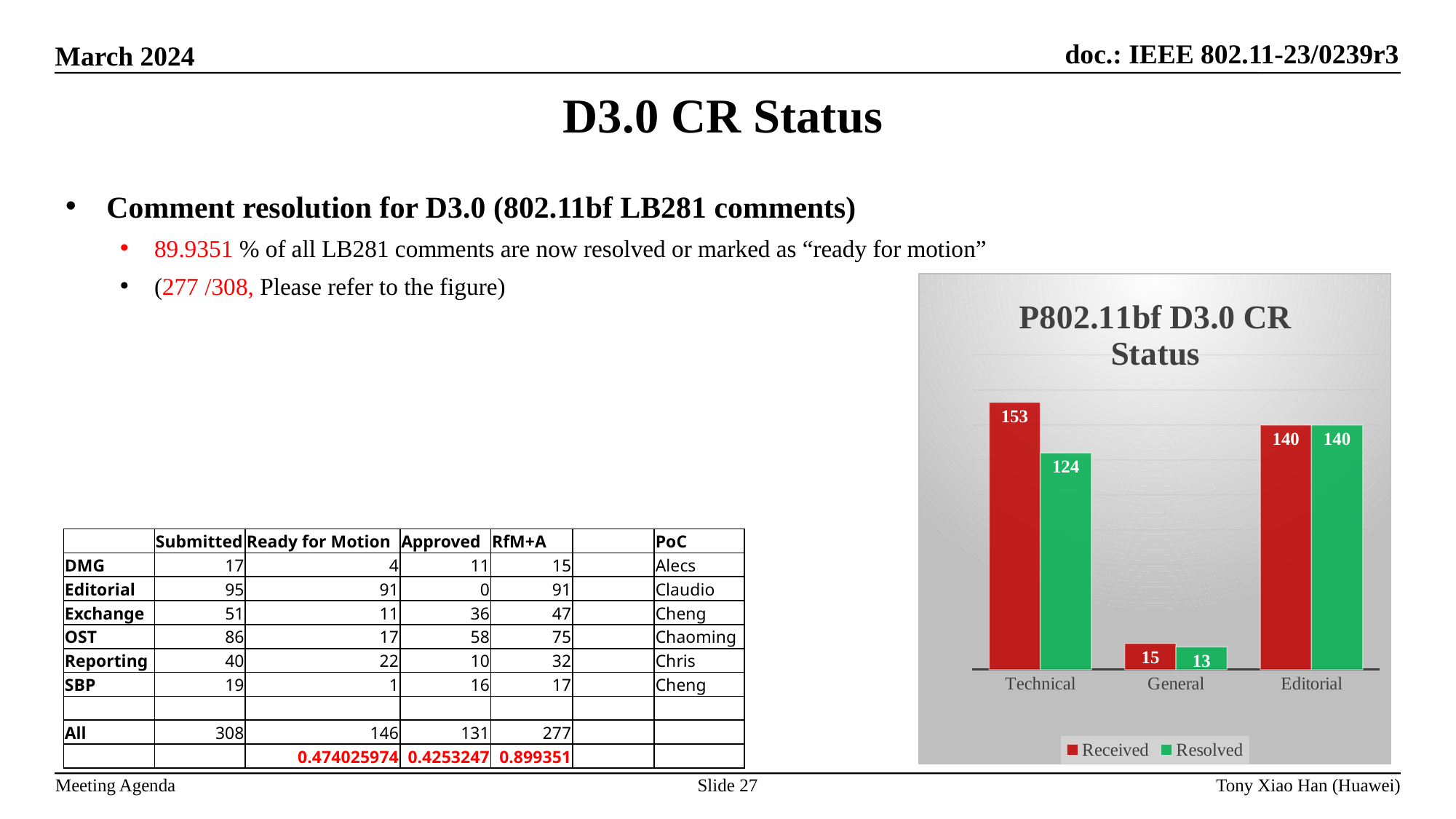
What is the Resolved value for Editorial? 140 What is the difference between Received and Resolved for General? 2 How many categories are shown on the x axis? 3 Which category has the highest Received value? Technical Which is larger, the Resolved value for Technical or the Resolved value for Editorial? Editorial What is the title of the chart? P802.11bf D3.0 CR Status What kind of chart is shown? bar chart Which category has the lowest Resolved value? General What is the Received value for Technical? 153 How many series does the legend list? 2 What is the Resolved value for General? 13 What is the difference between Received and Resolved for Technical? 29